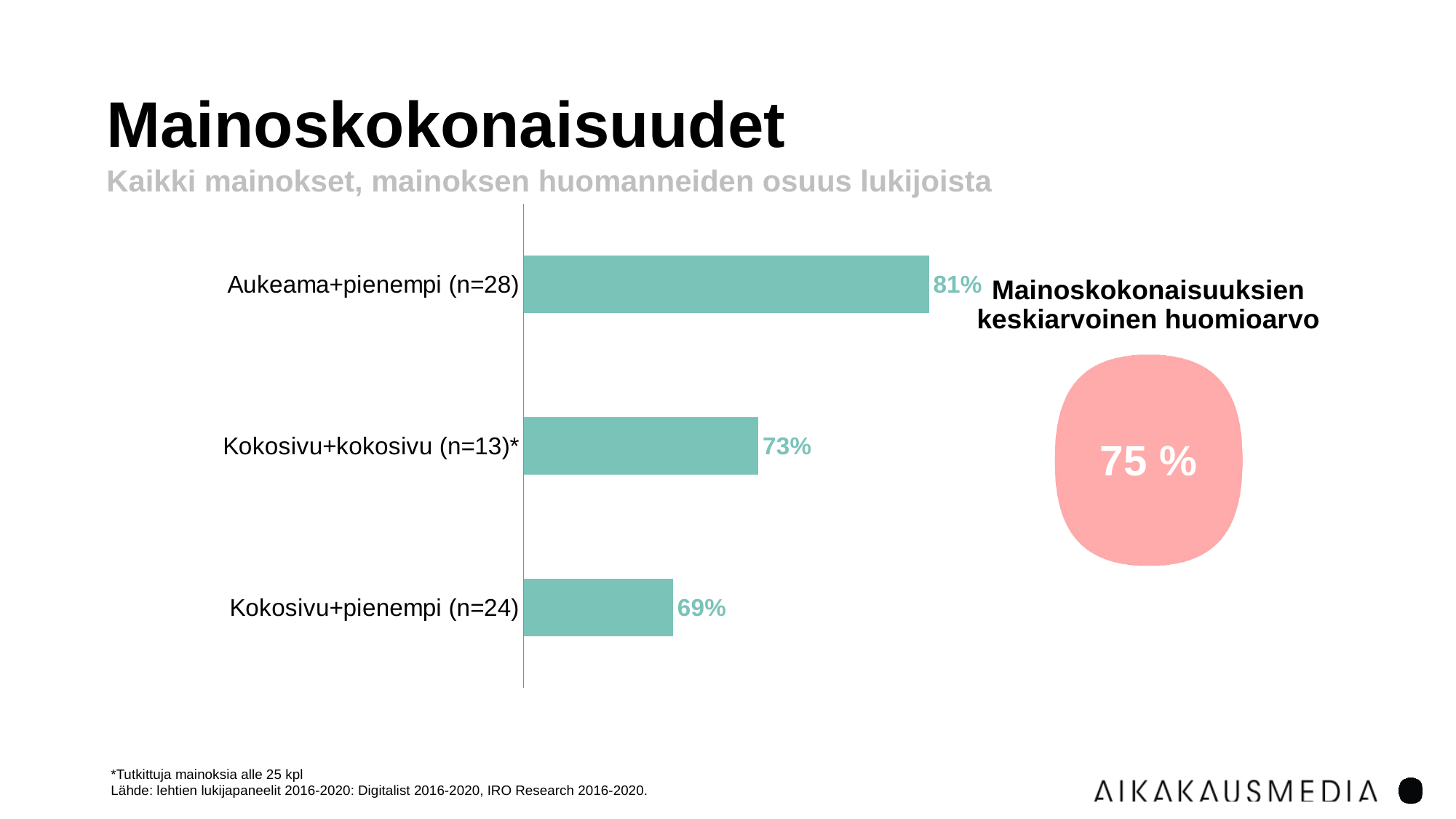
What is the value for Aukeama+pienempi (n=28)? 81% What is the difference between the values for Kokosivu+kokosivu (n=13)* and Kokosivu+pienempi (n=24)? 4% What is the subtitle of the chart? Kaikki mainokset, mainoksen huomanneiden osuus lukijoista Which category has the highest value? Aukeama+pienempi (n=28) What is the value for Kokosivu+pienempi (n=24)? 69% What kind of chart is shown on the slide? Bar chart Which category has the lowest value? Kokosivu+pienempi (n=24) What is the difference between the values for Aukeama+pienempi (n=28) and Kokosivu+pienempi (n=24)? 12% Which is larger, the value for Kokosivu+kokosivu (n=13)* or the value for Kokosivu+pienempi (n=24)? Kokosivu+kokosivu (n=13)* How many categories are shown in the bar chart? 3 What is the average attention value (keskiarvoinen huomioarvo) shown in the circle on the slide? 75 % What is the value for Kokosivu+kokosivu (n=13)*? 73%